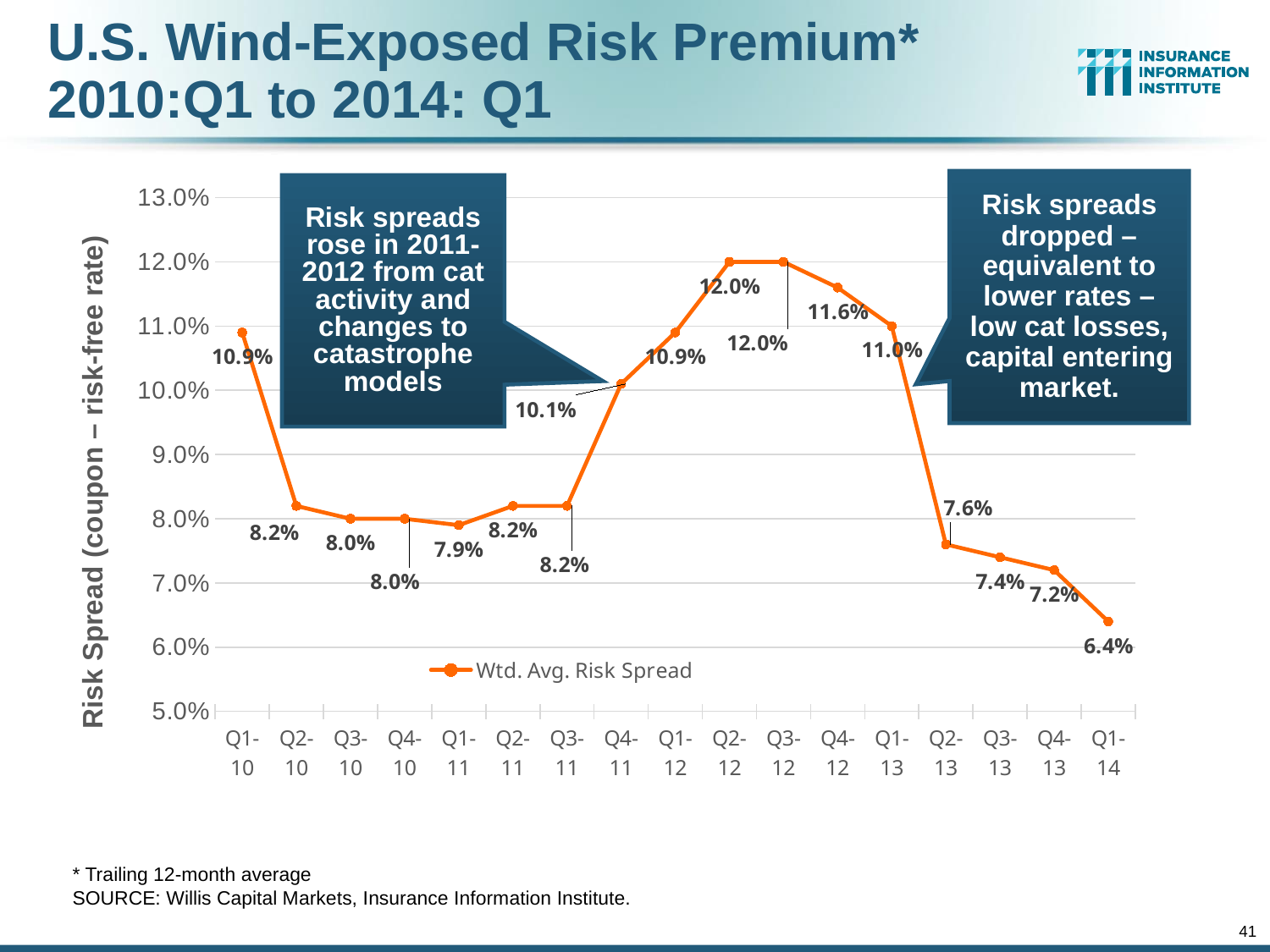
What is the weighted average risk spread for Q1-14? 6.4% What is the difference between the risk spread in Q1-13 and Q2-13? 3.4% What is the weighted average risk spread for Q1-11? 7.9% What series name does the legend show? Wtd. Avg. Risk Spread How many quarters are plotted on the x axis? 17 What type of chart is shown on the slide? Line chart What is the highest weighted average risk spread value shown on the chart? 12.0% Is the risk spread for Q3-13 greater or less than 8.0%? less What is the weighted average risk spread for Q4-11? 10.1% What is the weighted average risk spread for Q4-12? 11.6% Which is larger, the risk spread in Q1-10 or in Q1-12? They are equal (10.9%) Which quarter has the lowest weighted average risk spread? Q1-14